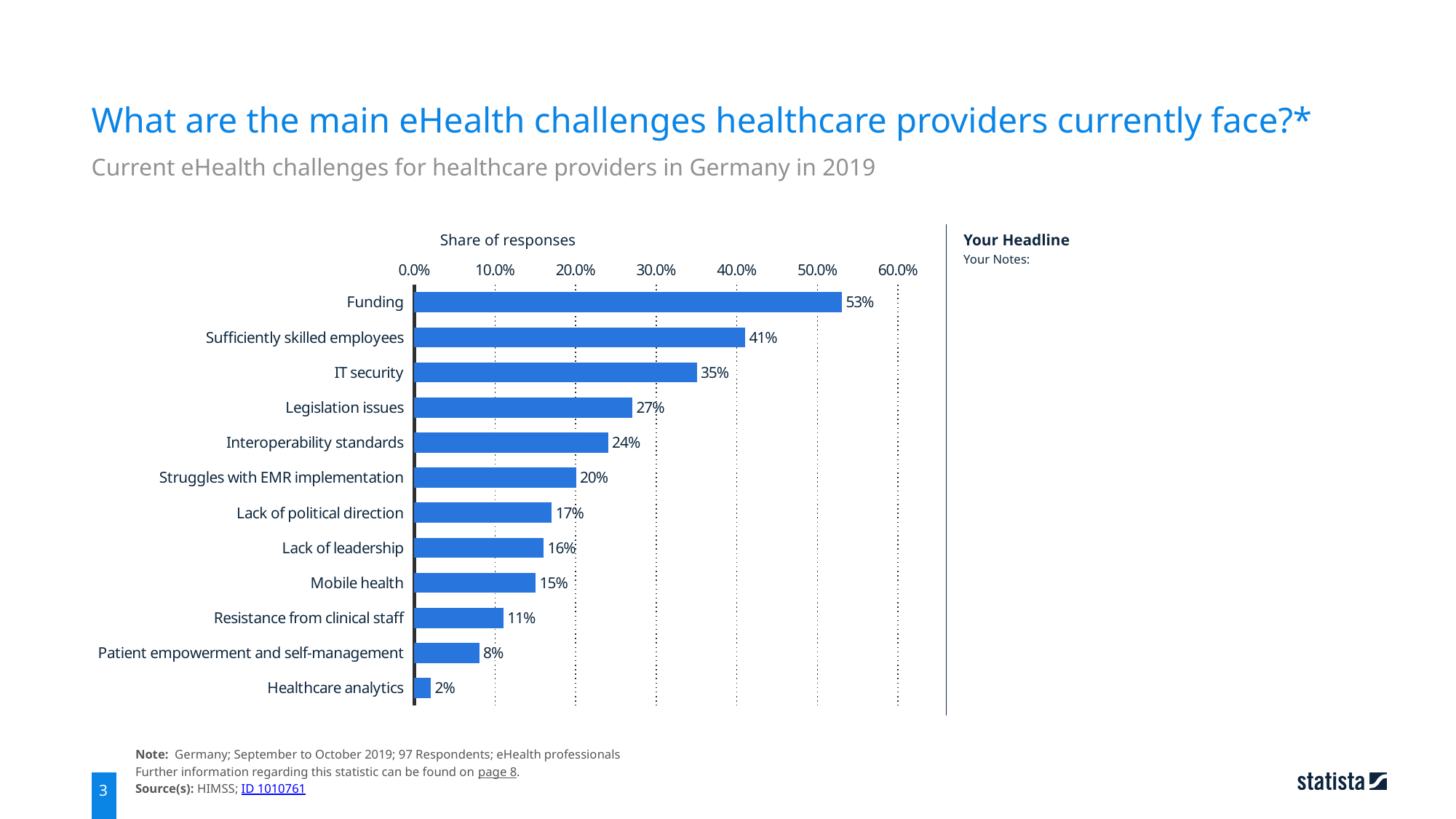
Which has a larger share of responses, Legislation issues or Interoperability standards? Legislation issues Which challenge has the lowest share of responses? Healthcare analytics Is the value for Sufficiently skilled employees greater or less than 40.0%? greater What kind of chart is shown on the slide? Bar chart What is the share of responses for Funding? 53% What is the difference in share of responses between Funding and Sufficiently skilled employees? 12% What is the title of the chart's value axis? Share of responses What is the share of responses for Mobile health? 15% What is the difference in share of responses between Resistance from clinical staff and Patient empowerment and self-management? 3% Which challenge has the highest share of responses? Funding How many challenges are shown in the chart? 12 What is the share of responses for IT security? 35%